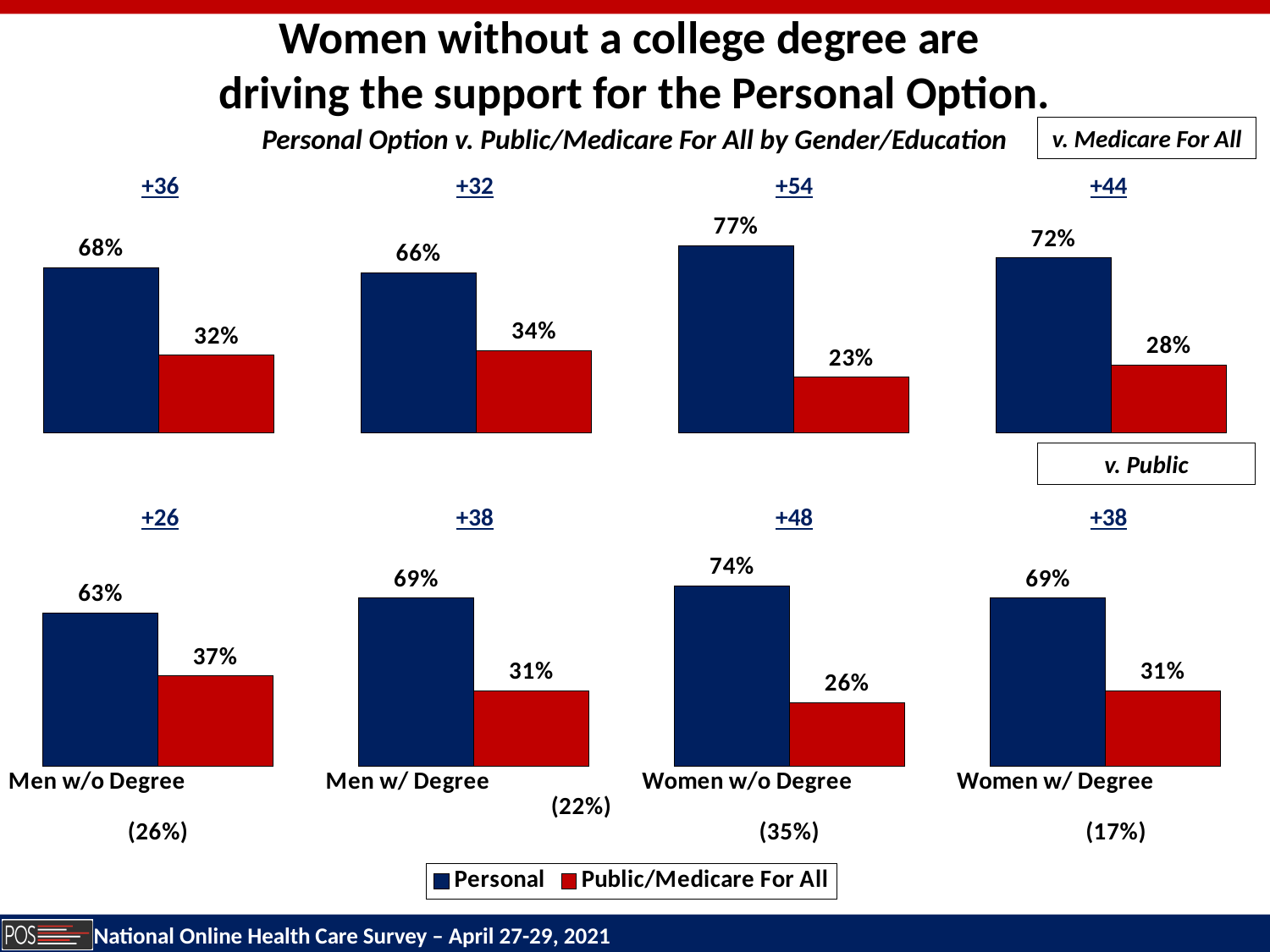
How many groups are shown along the x axis of the charts? 4 In the top row (v. Medicare For All), what is the Public/Medicare For All value for Women w/ Degree? 28% What kind of chart is used on this slide? Bar chart In the top row (v. Medicare For All), what is the difference between the Personal and Public/Medicare For All values for Men w/o Degree? 36 In the bottom row (v. Public), which group has the lowest Personal value? Men w/o Degree How many series does the legend list? 2 In the bottom row (v. Public), what is the Public/Medicare For All value for Men w/o Degree? 37% In the top row (v. Medicare For All), which is larger: the Public/Medicare For All value for Men w/ Degree or for Women w/o Degree? Men w/ Degree In the bottom row (v. Public), what is the Personal value for Men w/ Degree? 69% In the top row (v. Medicare For All), which group has the highest Personal value? Women w/o Degree In the top row (v. Medicare For All), what is the Personal value for Women w/o Degree? 77% In the bottom row (v. Public), what is the difference between the Personal and Public/Medicare For All values for Women w/o Degree? 48